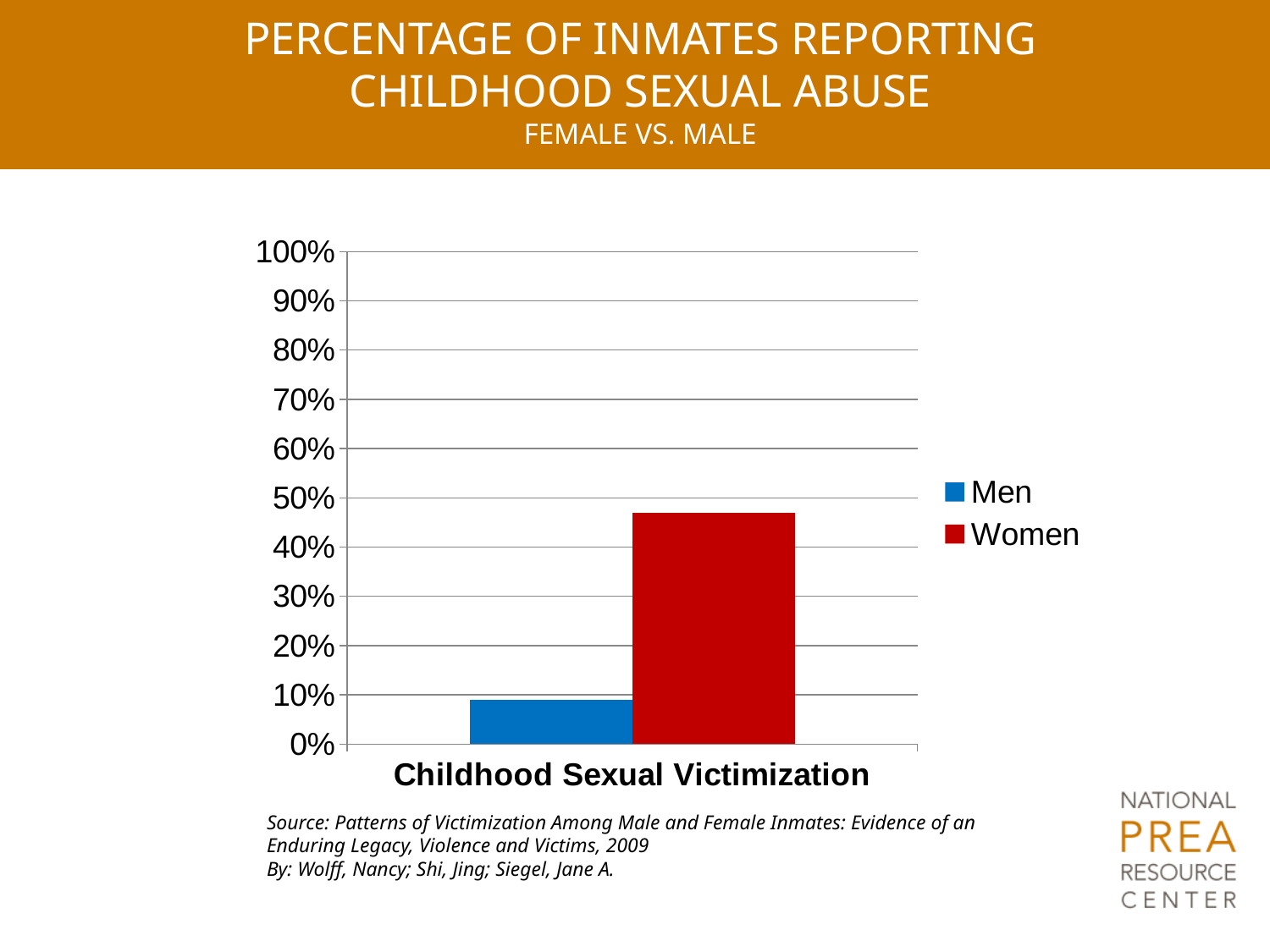
How many categories are shown on the x axis? 1 Is the value for Men greater or less than 20%? less Which colour represents the Women series in the legend? red Is the value for Men greater or less than 30%? less Is the value for Women greater or less than 40%? greater What is the label of the category on the x axis? Childhood Sexual Victimization How many series does the legend list? 2 Which series has the higher value for Childhood Sexual Victimization, Men or Women? Women What kind of chart is shown on the slide? bar chart Which series has the highest bar in the chart? Women Which series has the lowest bar in the chart? Men